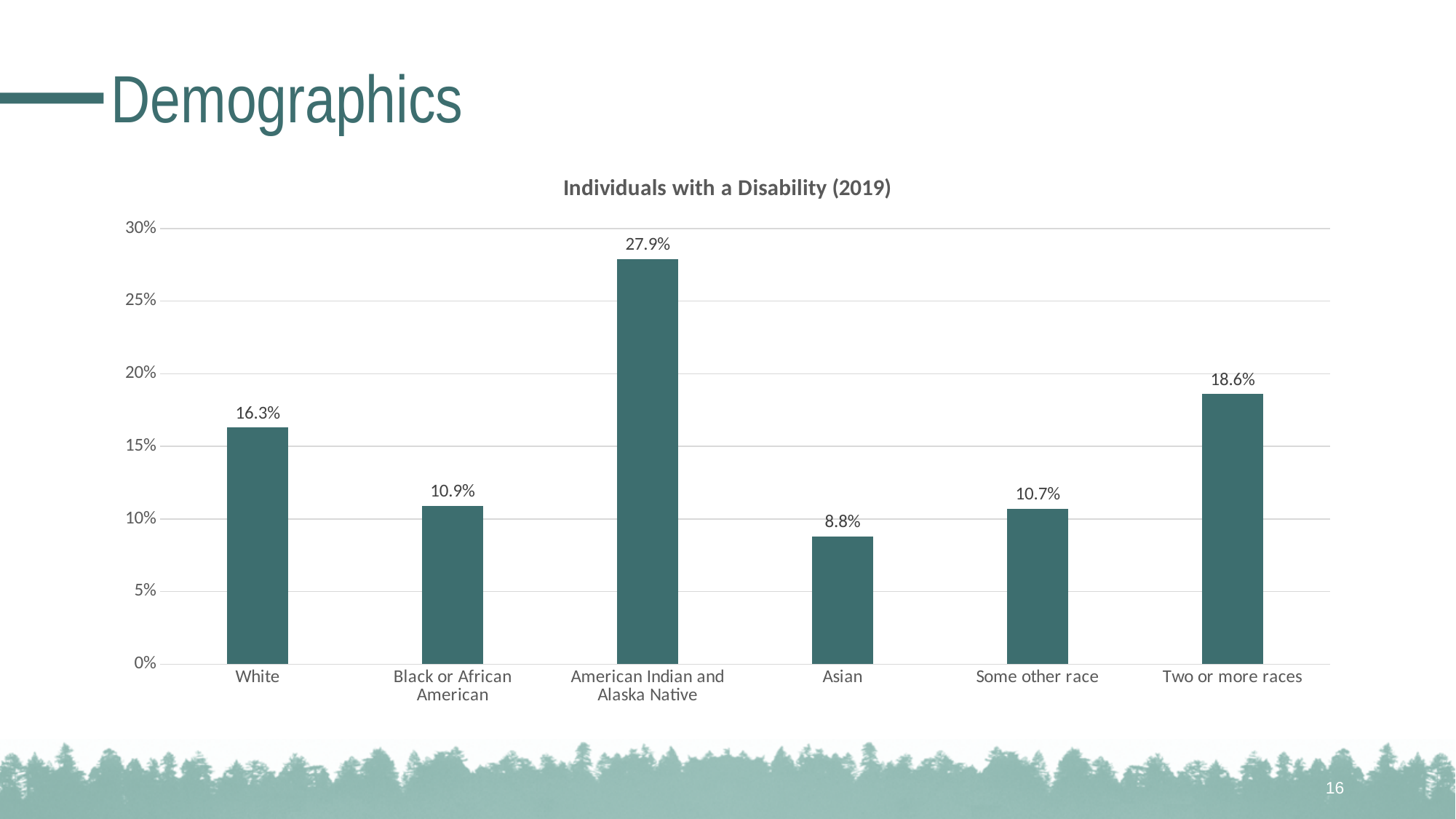
Which category has the highest value? American Indian and Alaska Native What is the value for American Indian and Alaska Native? 27.9% Is the value for Two or more races greater or less than 20%? less What is the value for Two or more races? 18.6% What is the value for Asian? 8.8% What is the value for White? 16.3% Which is larger, the value for White or the value for Black or African American? White What kind of chart is shown on the slide? bar chart What is the difference between the values for American Indian and Alaska Native and White? 11.6% What is the difference between the values for Two or more races and Some other race? 7.9% How many categories are shown on the x axis? 6 Which category has the lowest value? Asian